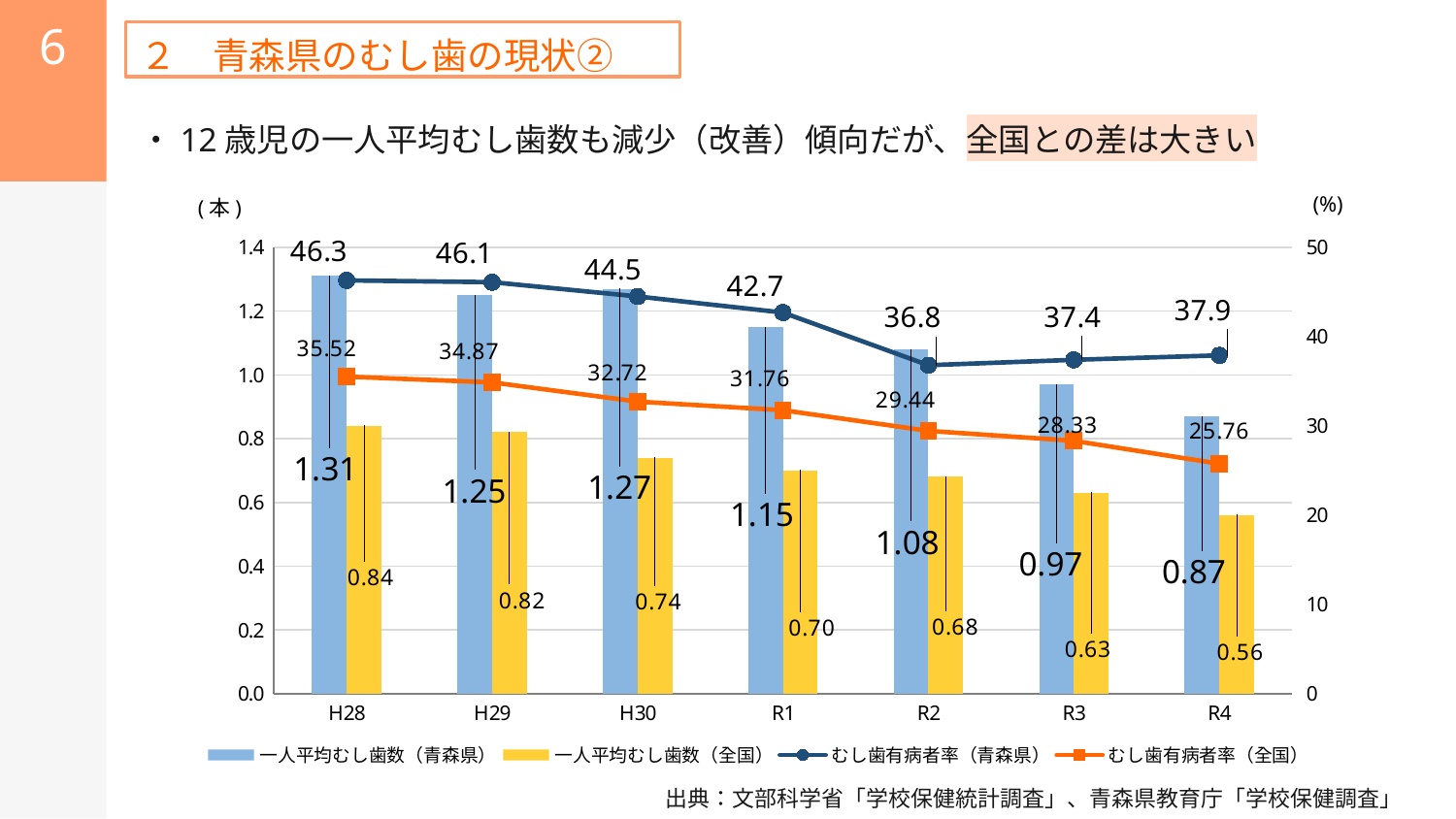
Which is larger for R3: むし歯有病者率（青森県） or むし歯有病者率（全国）? むし歯有病者率（青森県） Does むし歯有病者率（全国） rise or fall from H28 to R4? Fall How many years are shown on the x axis? 7 How many series does the legend list? 4 What kind of chart is this? Combined bar and line chart In which year is 一人平均むし歯数（青森県） the lowest? R4 What is the value of むし歯有病者率（青森県） for R2? 36.8 What is the value of 一人平均むし歯数（全国） for R4? 0.56 What is the value of 一人平均むし歯数（青森県） for H28? 1.31 What is the value of むし歯有病者率（全国） for H30? 32.72 What is the difference between 一人平均むし歯数（青森県） and 一人平均むし歯数（全国） for R1? 0.45 In which year is むし歯有病者率（青森県） the highest? H28